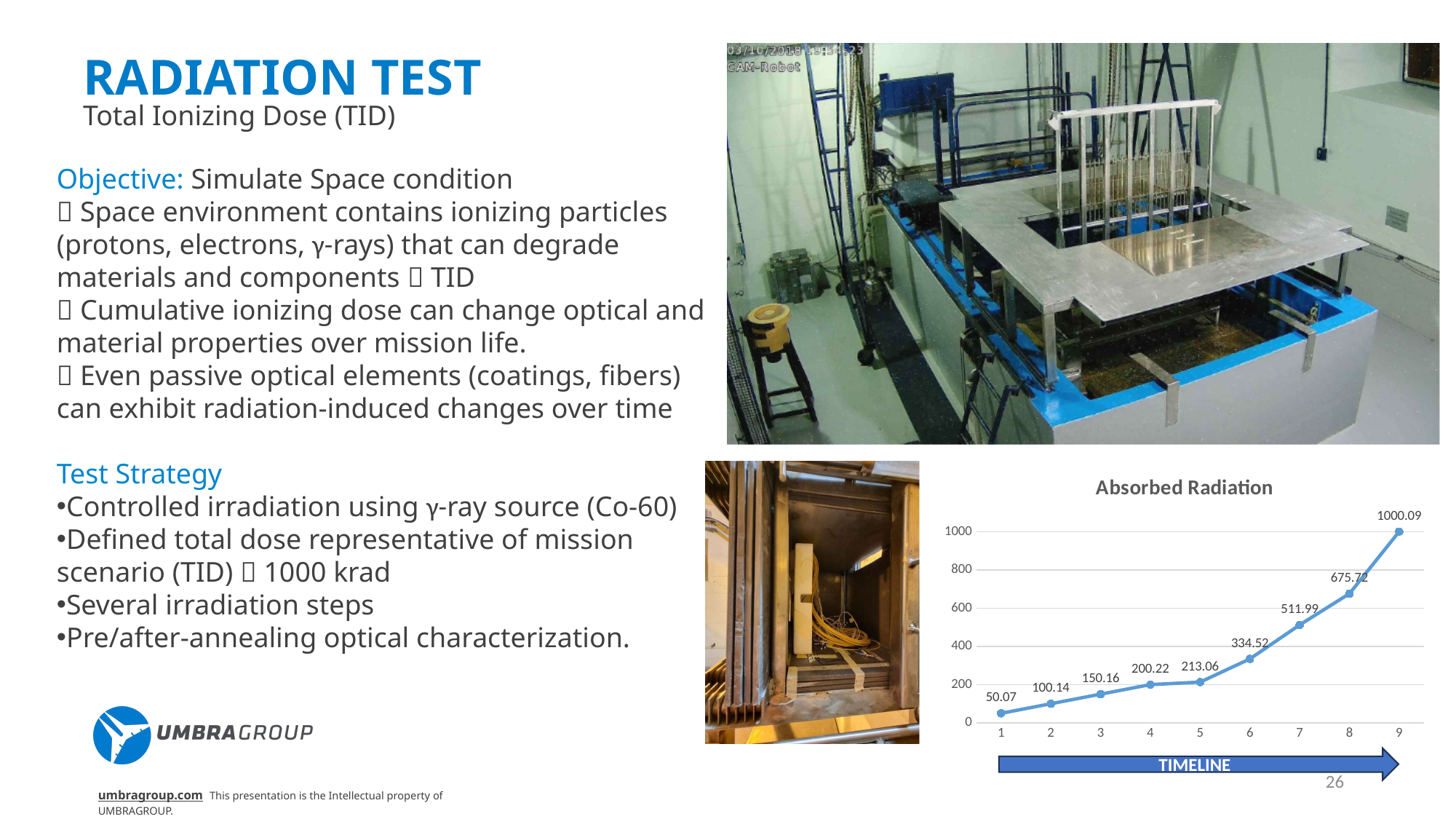
Do the absorbed radiation values rise or fall along the x axis? rise What is the title of the chart on the slide? Absorbed Radiation Which is larger, the absorbed radiation at point 6 or at point 4? point 6 At which point on the x axis is the absorbed radiation lowest? 1 What is the absorbed radiation value at point 9? 1000.09 How many data points are plotted in the "Absorbed Radiation" chart? 9 What is the absorbed radiation value at point 7? 511.99 What type of chart is the "Absorbed Radiation" chart? line chart What is the absorbed radiation value at point 1? 50.07 What is the absorbed radiation value at point 5? 213.06 What is the difference between the absorbed radiation at point 9 and at point 8? 324.37 At which point on the x axis is the absorbed radiation highest? 9